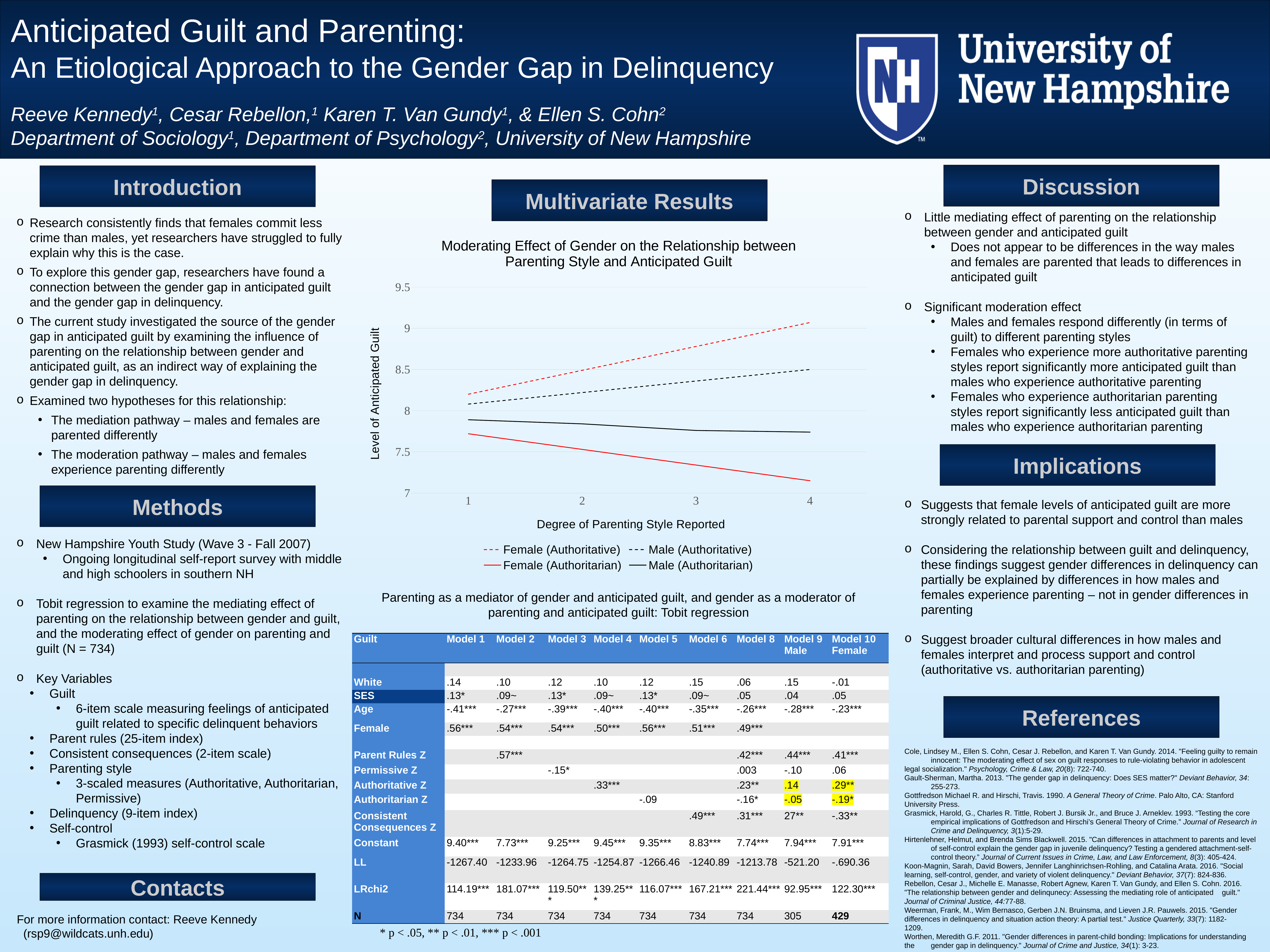
Is the value for Female (Authoritarian) at degree 4 greater or less than 7.5? less At degree 4, which is higher: Female (Authoritative) or Male (Authoritative)? Female (Authoritative) What kind of chart is shown under the Multivariate Results heading? line chart Which series has the highest level of anticipated guilt at degree 4? Female (Authoritative) What is the label of the y axis of the line chart? Level of Anticipated Guilt Does the Female (Authoritative) line rise or fall as the degree of parenting style reported increases from 1 to 4? rise How many points along the x axis (Degree of Parenting Style Reported) does the line chart show? 4 Is the value for Female (Authoritative) at degree 4 greater or less than 8.5? greater Does the Female (Authoritarian) line rise or fall as the degree of parenting style reported increases from 1 to 4? fall How many series does the legend of the line chart list? 4 At degree 4, which is higher: Female (Authoritarian) or Male (Authoritarian)? Male (Authoritarian) Which series has the lowest level of anticipated guilt at degree 4? Female (Authoritarian)